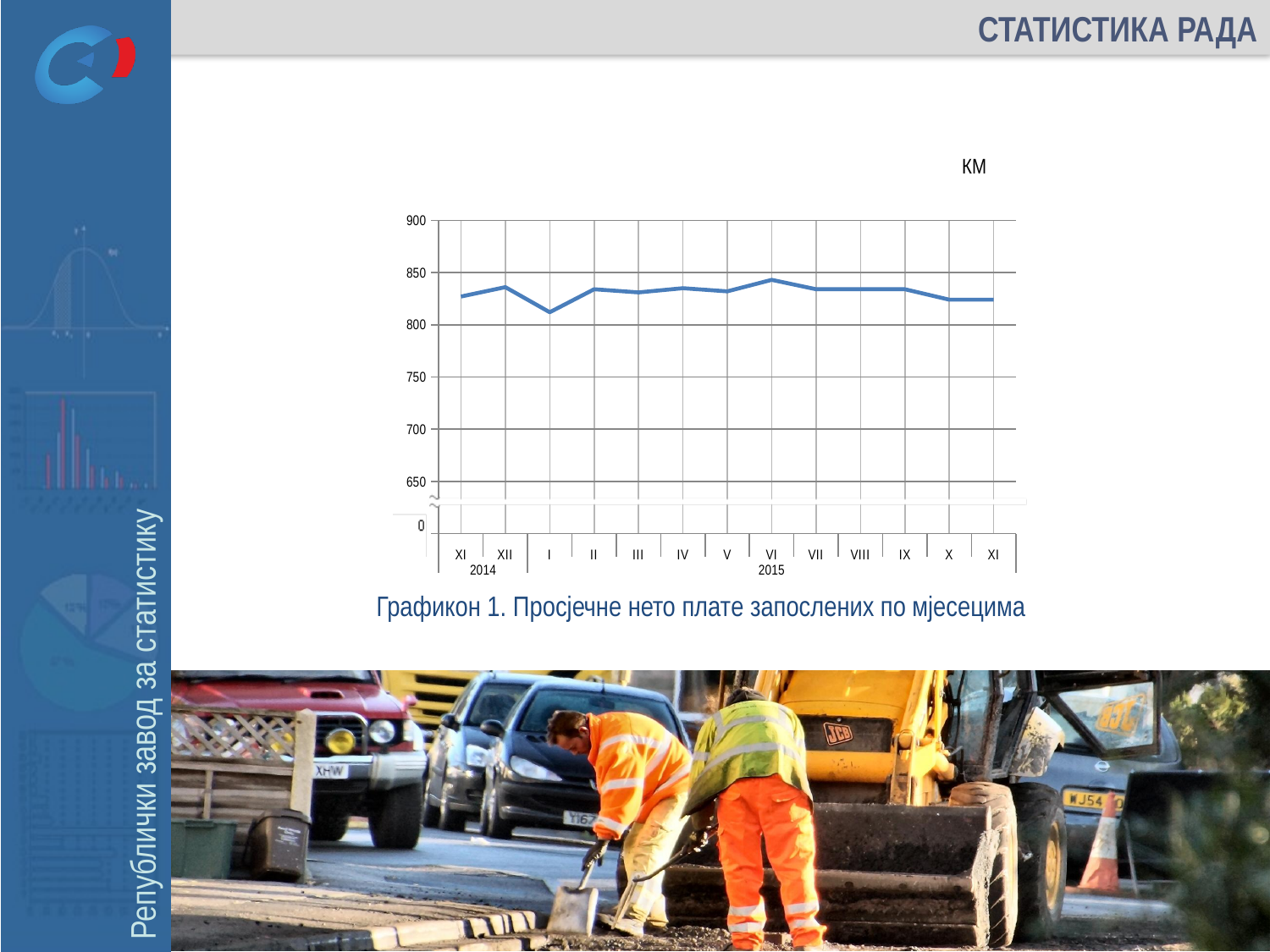
Is the value for I 2015 greater or less than 800? greater In which month is the average net wage highest? VI 2015 What kind of chart is shown on the slide? line chart Does the line rise or fall from VI 2015 to XI 2015? fall How many monthly data points are plotted on the chart? 13 What unit is indicated above the chart? KM What is the title of the chart? Графикон 1. Просјечне нето плате запослених по мјесецима Is the value for VI 2015 greater or less than 850? less Which is larger, the value for XII 2014 or the value for I 2015? XII 2014 Is the value for XI 2015 greater or less than 850? less In which month is the average net wage lowest? I 2015 Which is larger, the value for VI 2015 or the value for I 2015? VI 2015